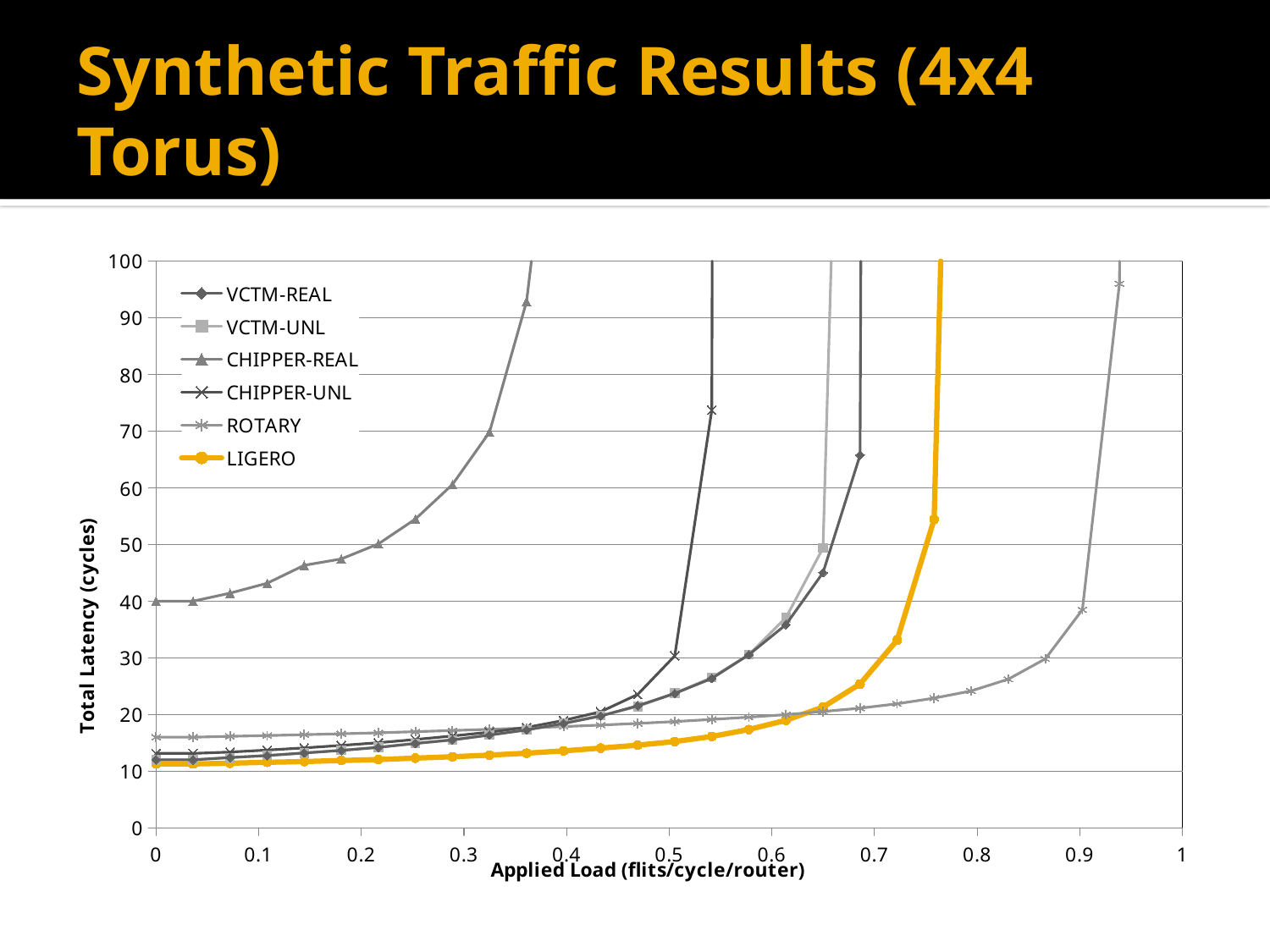
Which series has the highest total latency at an applied load of 0? CHIPPER-REAL Is the total latency of ROTARY at an applied load of 0 greater or less than 20? less Is the total latency of CHIPPER-REAL at an applied load of 0 greater or less than 30? greater Which series reaches 100 cycles of latency at the lowest applied load? CHIPPER-REAL What is the title of the slide containing the chart? Synthetic Traffic Results (4x4 Torus) Which series is drawn in orange/yellow? LIGERO Is the total latency of LIGERO at an applied load of 0.5 greater or less than 20? less At an applied load of 0.5, which has the higher total latency, VCTM-REAL or LIGERO? VCTM-REAL Does the total latency of LIGERO rise or fall as applied load increases? rise What kind of chart is shown on the slide? line chart Which series sustains the highest applied load before its latency shoots up to 100 cycles? ROTARY How many series does the legend list? 6